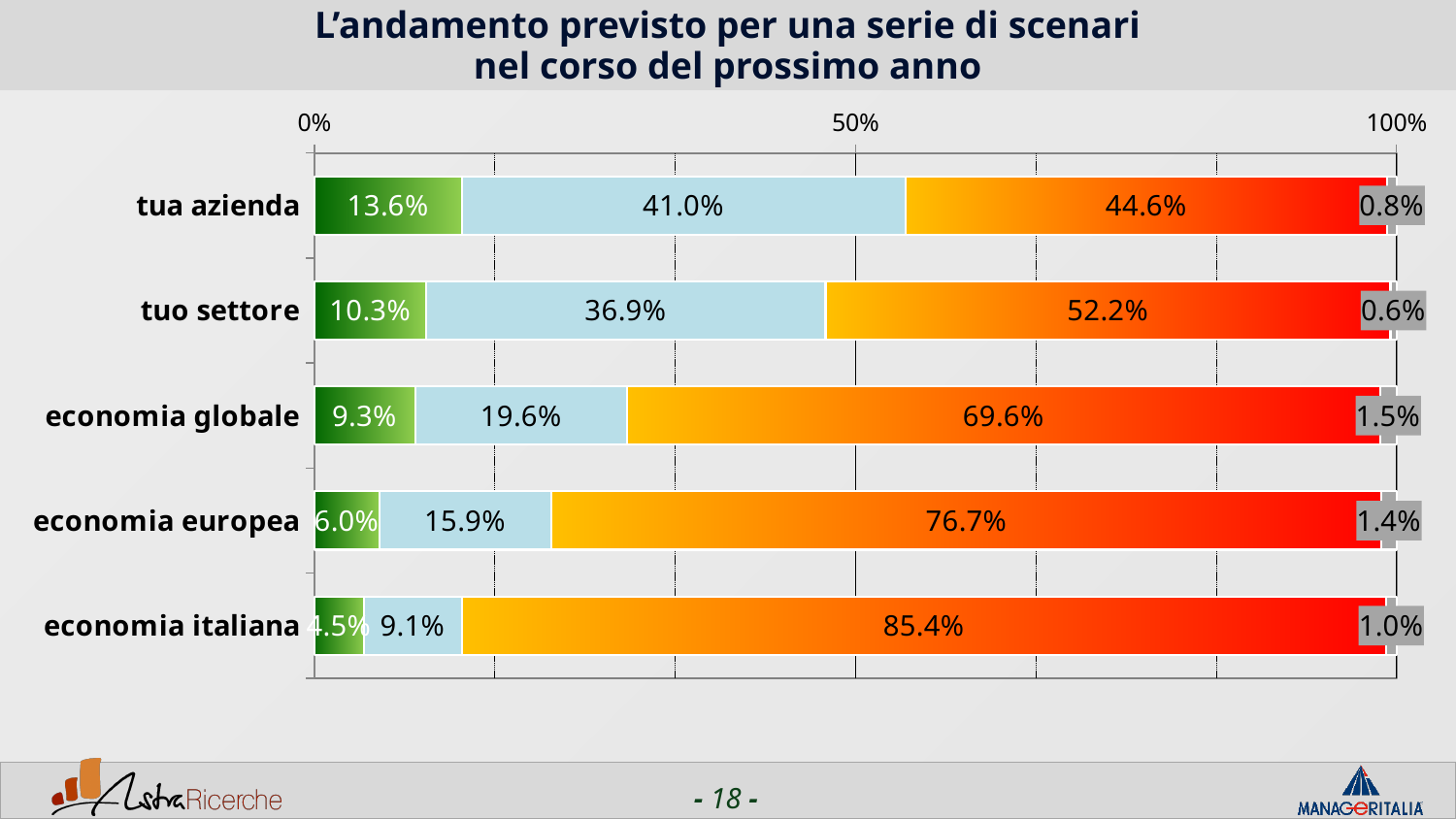
What is the value of the green segment for 'tua azienda'? 13.6% What is the difference between the light blue segment for 'tua azienda' and the light blue segment for 'tuo settore'? 4.1 percentage points Which category has the smallest green segment? economia italiana What is the value of the orange segment for 'economia italiana'? 85.4% What is the title of the chart? L'andamento previsto per una serie di scenari nel corso del prossimo anno Which has the larger orange segment, 'economia globale' or 'economia europea'? economia europea How many categories (scenarios) are plotted on the chart? 5 Going down the chart from 'tua azienda' to 'economia italiana', do the orange segment values rise or fall? Rise What kind of chart is shown on the slide? Stacked bar chart Which category has the largest orange segment? economia italiana What is the value of the grey segment at the right end of the 'economia globale' bar? 1.5% What is the total of all segments in the 'tua azienda' bar? 100.0%